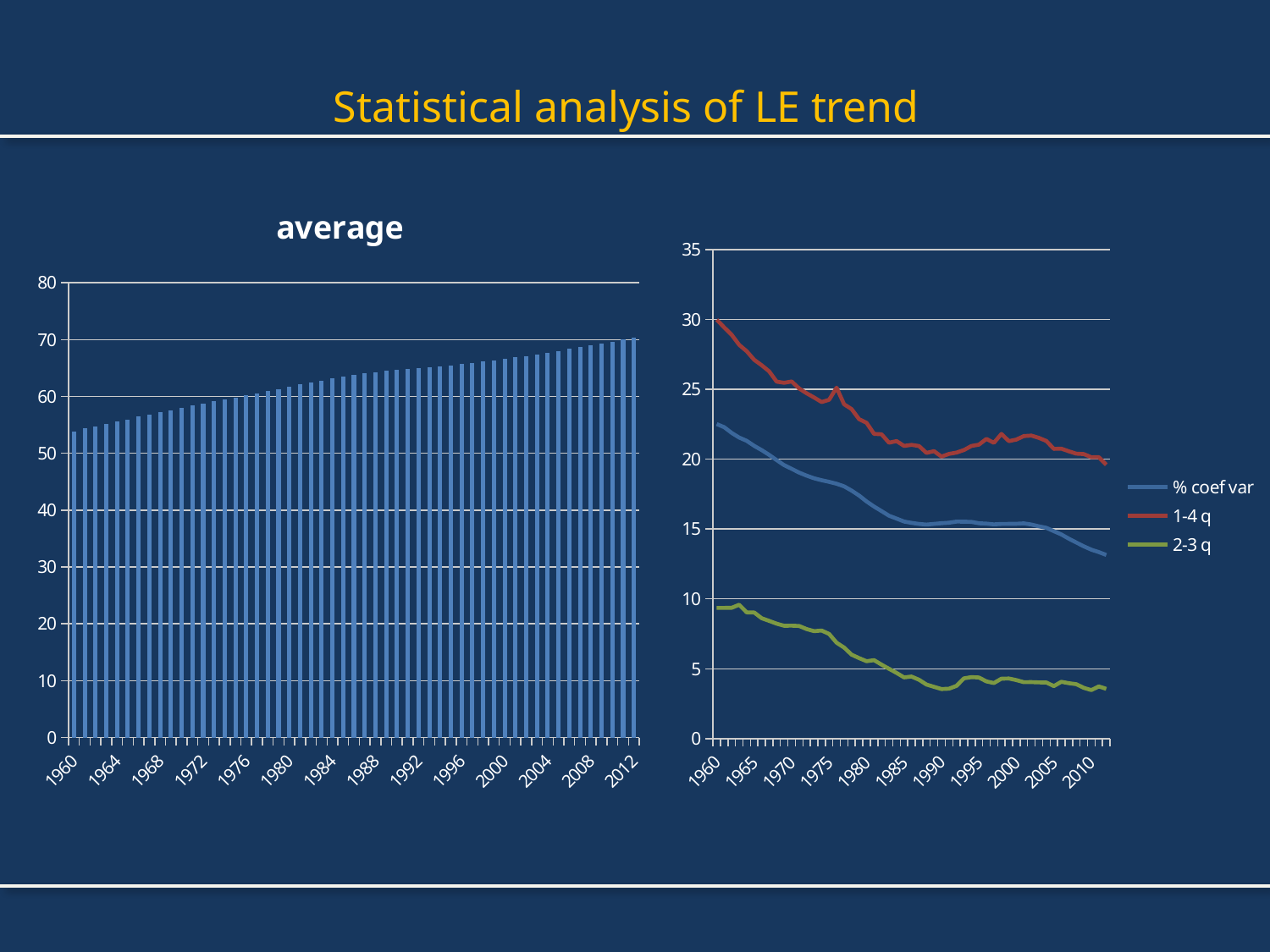
In the left chart titled "average", is the value for 2012 greater or less than 60? greater In the right chart, which series has the lowest values throughout the period? 2-3 q In the right chart, which series is drawn in green? 2-3 q In the right chart, does the "1-4 q" series rise or fall from 1960 to 2012? fall In the right chart, is the value of "2-3 q" in 2010 greater or less than 5? less In the left chart titled "average", is the value for 1960 greater or less than 50? greater What kind of chart is the right chart? line chart In the left chart titled "average", do the values rise or fall from 1960 to 2012? rise How many series does the legend of the right chart list? 3 What kind of chart is the left chart titled "average"? bar chart In the right chart, which series has the highest values throughout the period? 1-4 q